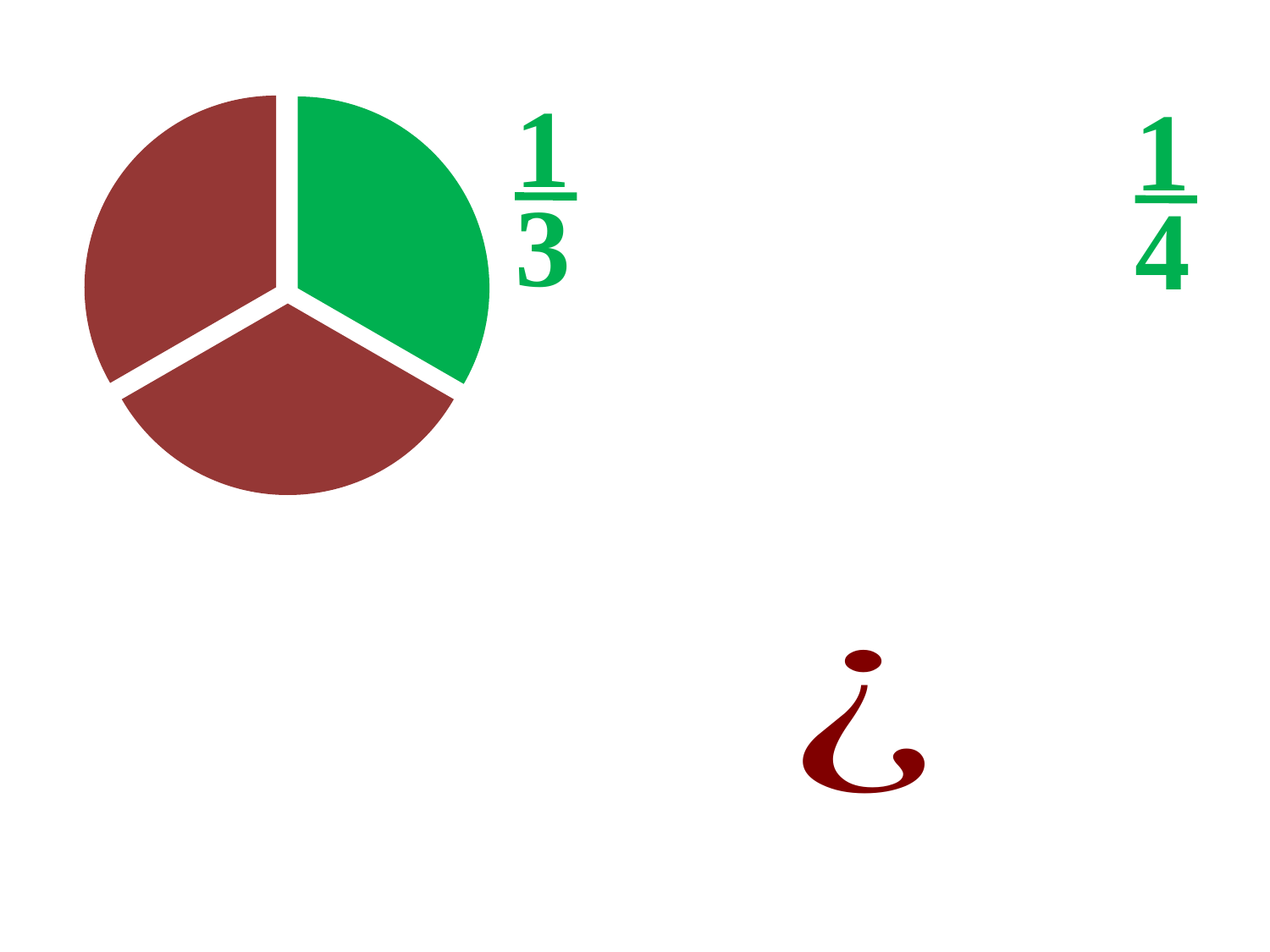
How many slices does the pie chart have? 3 What fraction is printed next to the green slice of the pie chart? 1/3 How many slices of the pie chart are coloured dark red? 2 How many slices of the pie chart are coloured green? 1 Are the slices of the pie chart equal in size? yes What kind of chart is shown on the slide? pie chart